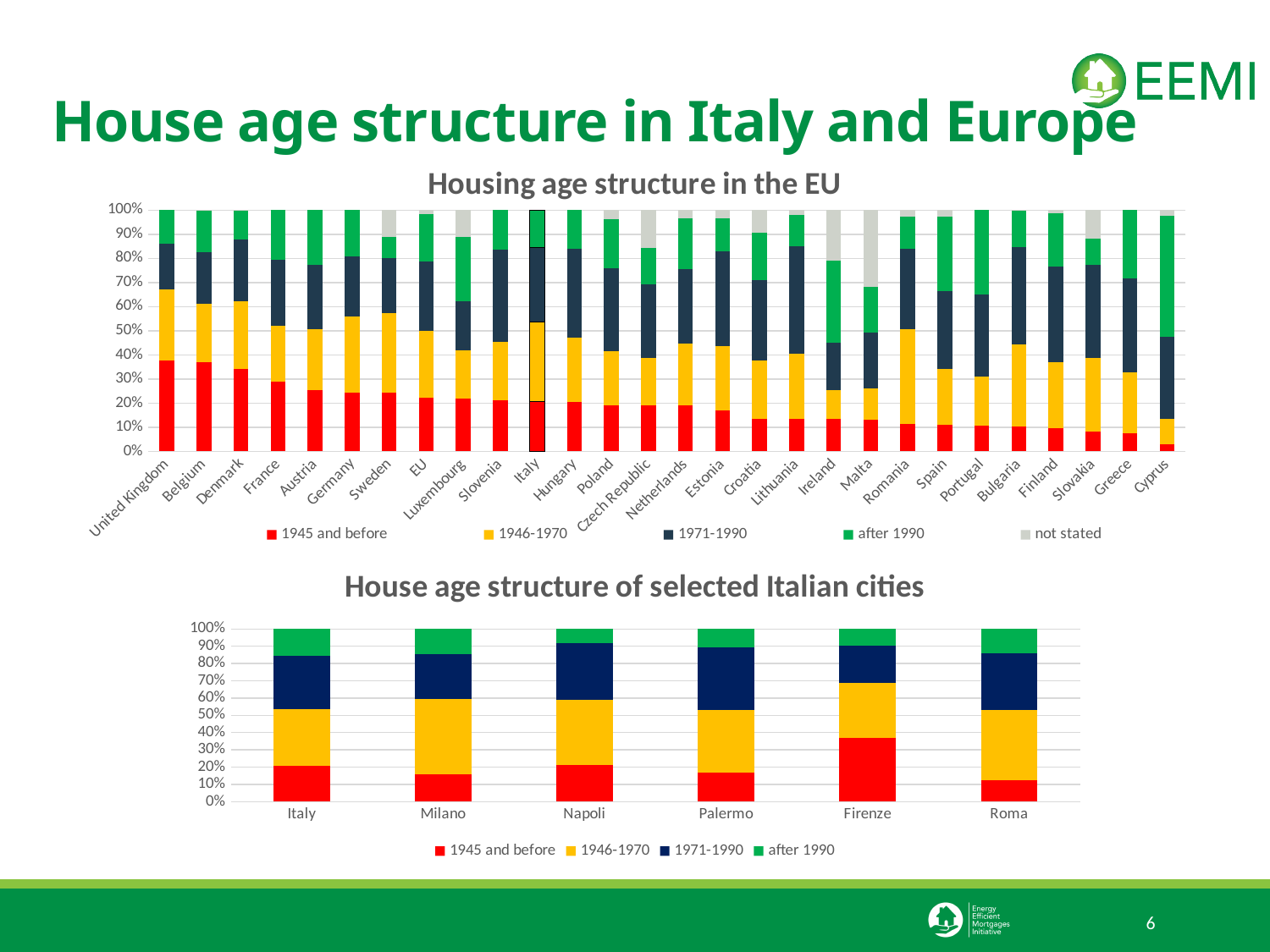
In the 'Housing age structure in the EU' chart, which country has the lowest share of houses built in 1945 and before? Cyprus What kind of chart is the 'Housing age structure in the EU' chart? Stacked bar chart In the 'Housing age structure in the EU' chart, is the '1945 and before' share for United Kingdom greater or less than 30%? greater How many series does the legend of the 'House age structure of selected Italian cities' chart list? 4 How many cities or categories are shown on the x axis of the 'House age structure of selected Italian cities' chart? 6 In the 'House age structure of selected Italian cities' chart, is the '1945 and before' share for Firenze greater or less than 30%? greater In the 'House age structure of selected Italian cities' chart, which has the larger '1945 and before' share, Firenze or Roma? Firenze How many countries or regions are shown on the x axis of the 'Housing age structure in the EU' chart? 28 In the 'Housing age structure in the EU' chart, does the '1945 and before' share rise or fall moving from left to right along the x axis? fall In the 'Housing age structure in the EU' chart, is the '1945 and before' share for Cyprus greater or less than 10%? less How many series does the legend of the 'Housing age structure in the EU' chart list? 5 In the 'House age structure of selected Italian cities' chart, which city has the highest share of houses built in 1945 and before? Firenze